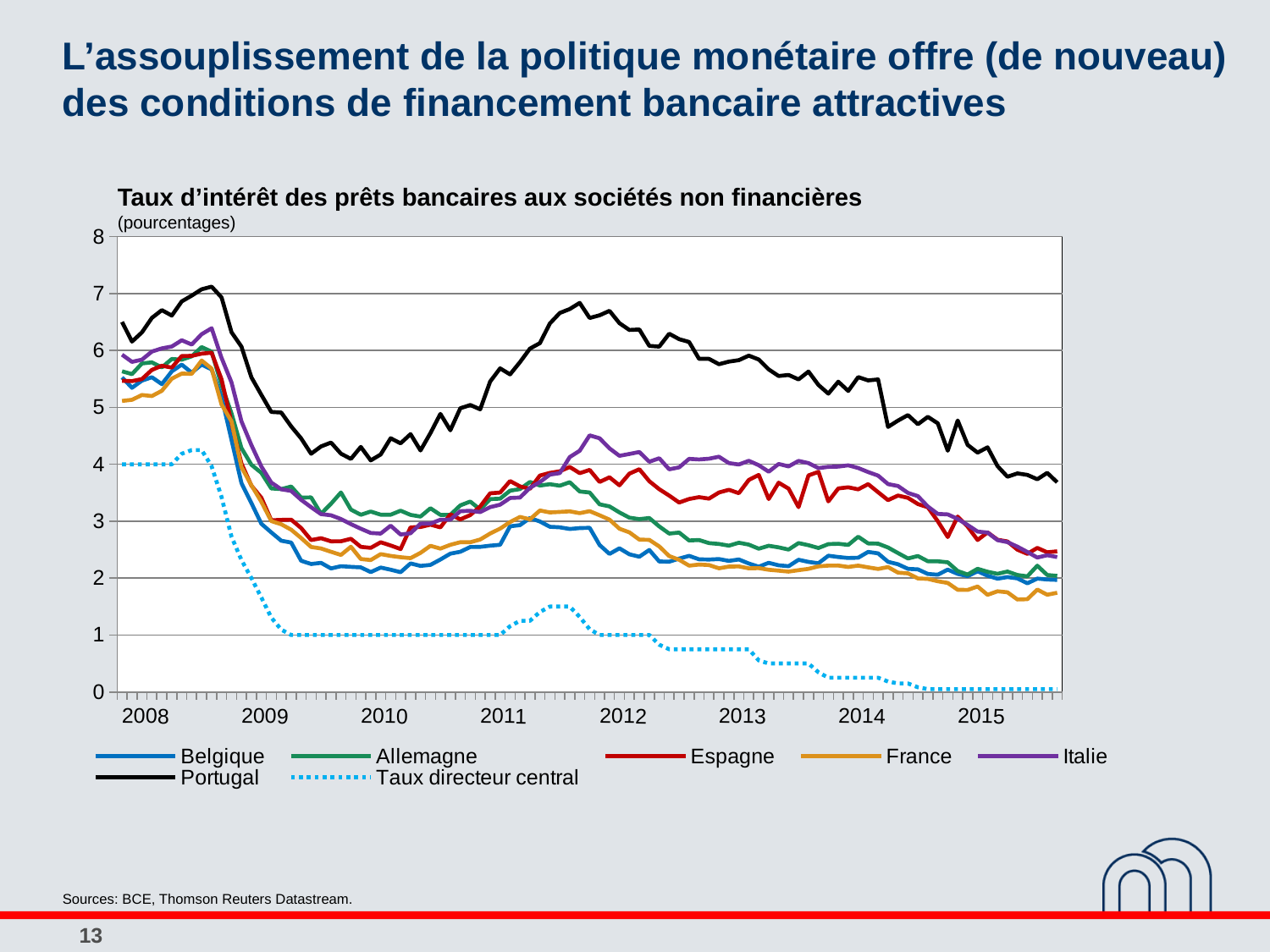
How many series does the legend of the chart list? 7 What kind of chart is shown on the slide? line chart Which series is drawn as a dotted line in the chart? Taux directeur central In 2013, which series has the larger value, Italie or France? Italie Which series has the highest values across the chart, for example in 2012? Portugal Does the value for Portugal rise or fall between 2014 and the end of 2015? fall What is the title of the chart? Taux d'intérêt des prêts bancaires aux sociétés non financières Is the value for Portugal at the start of 2008 greater or less than 6? greater How many year labels are shown on the x axis of the chart? 8 Which series has the lowest values across the chart, for example in 2015? Taux directeur central Is the value for Belgique at the end of 2015 greater or less than 3? less Is the value for Taux directeur central during 2010 greater or less than 2? less